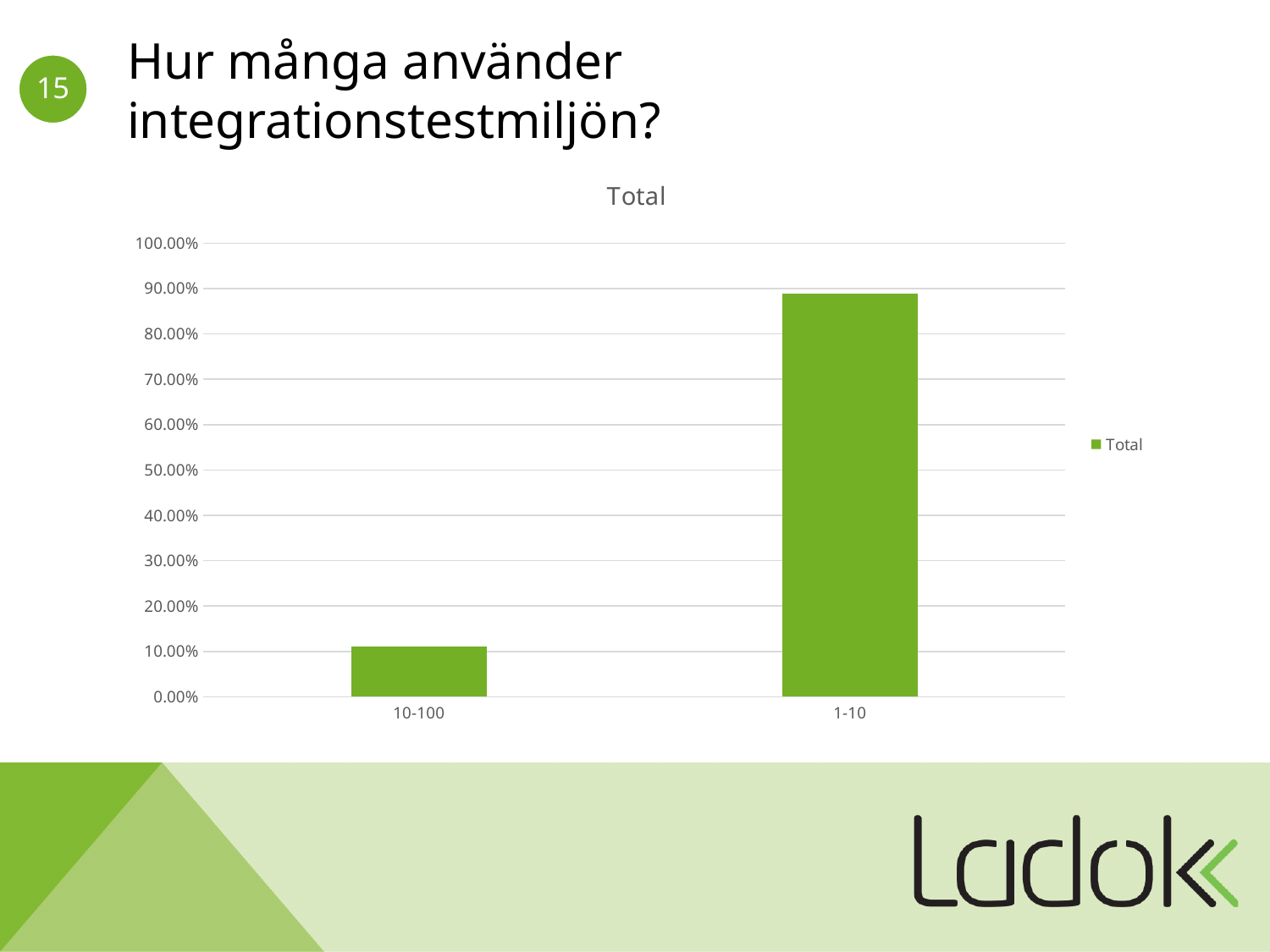
What is the title of the chart? Total Which category has the highest value in the chart? 1-10 Which category has the lowest value in the chart? 10-100 What kind of chart is shown on the slide? bar chart Is the value for 10-100 greater or less than 50.00%? less What is the name of the series listed in the chart's legend? Total Is the value for 1-10 greater or less than 80.00%? greater Which category has the larger value, 10-100 or 1-10? 1-10 How many series does the chart's legend list? 1 Is the value for 10-100 greater or less than 20.00%? less How many categories are shown on the x axis of the chart? 2